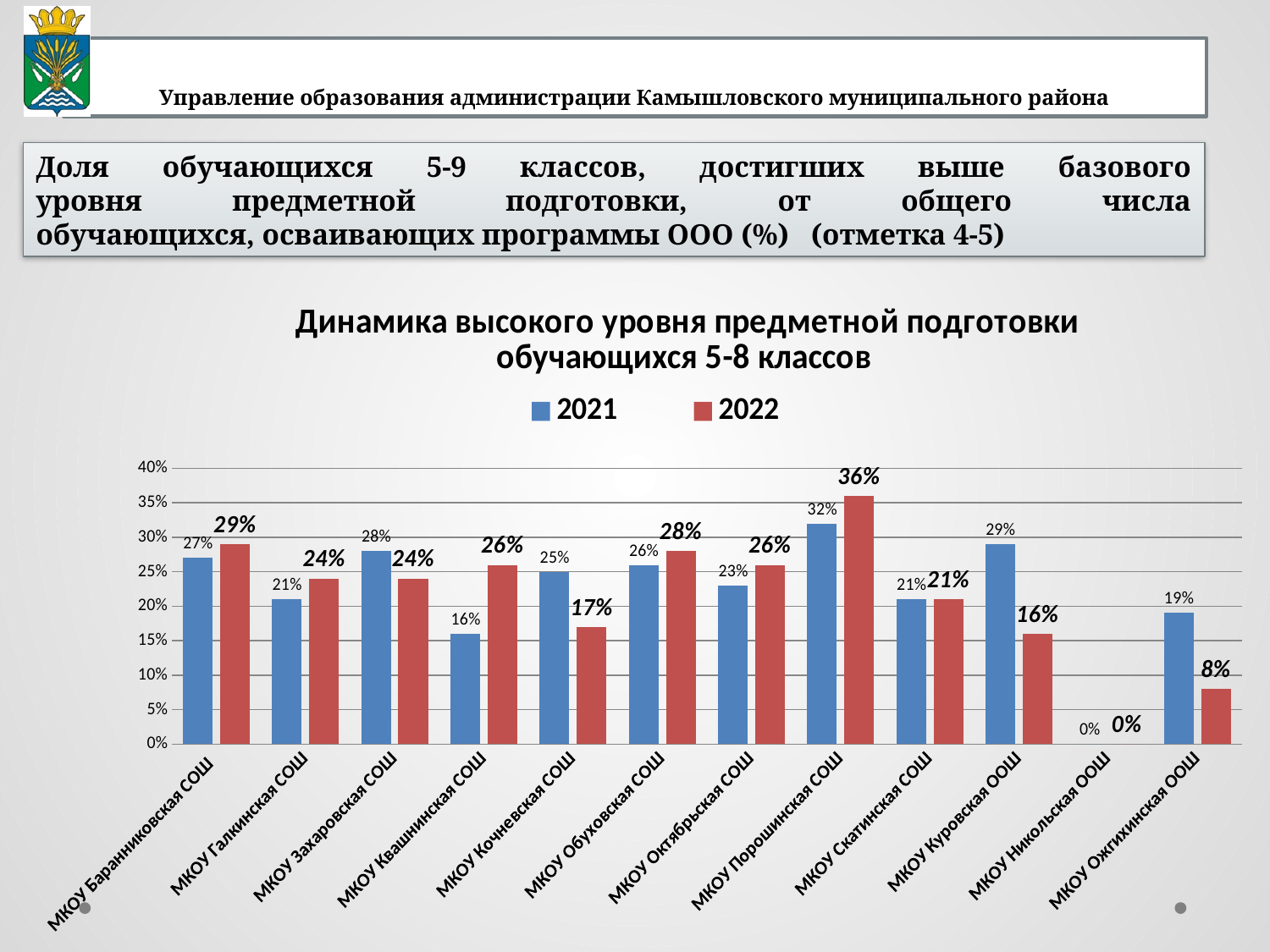
For МКОУ Кочневская СОШ, which is larger: the 2021 value or the 2022 value? 2021 What is the 2022 value for МКОУ Порошинская СОШ? 36% What is the difference between the 2021 and 2022 values for МКОУ Куровская ООШ? 13% Which school has the highest 2022 value? МКОУ Порошинская СОШ What is the 2022 value for МКОУ Ожгихинская ООШ? 8% What is the 2021 value for МКОУ Квашнинская СОШ? 16% How many series does the legend list? 2 How many schools (categories) are shown on the x axis? 12 What type of chart is shown on the slide? bar chart Which school has the lowest 2021 value? МКОУ Никольская ООШ What is the difference between the 2022 and 2021 values for МКОУ Квашнинская СОШ? 10% What is the title of the chart? Динамика высокого уровня предметной подготовки обучающихся 5-8 классов